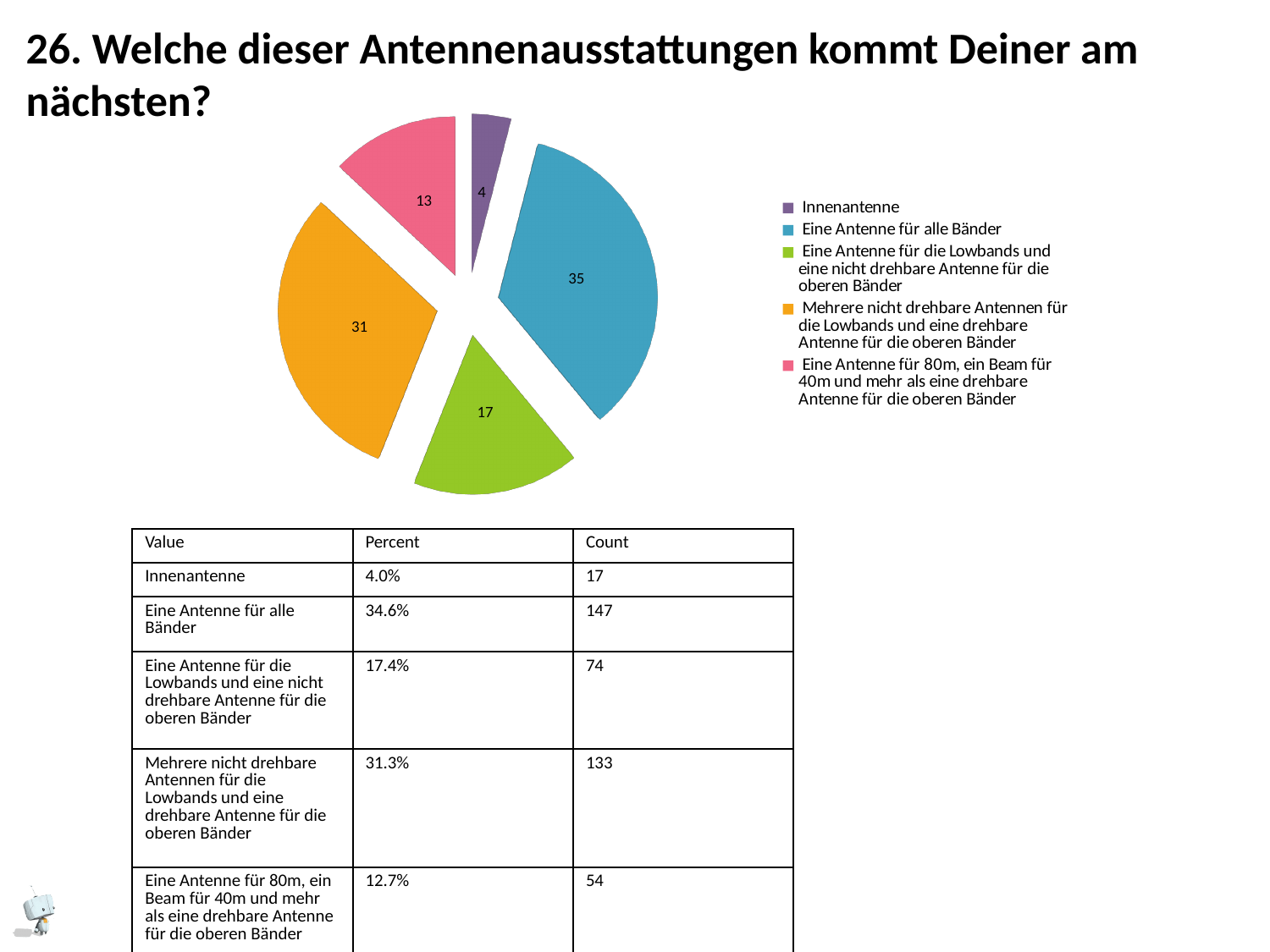
How many slices does the pie chart have? 5 Which category has the largest slice in the pie chart? Eine Antenne für alle Bänder What value is labelled on the pie slice for "Innenantenne"? 4 What is the difference between the labelled values of the "Eine Antenne für alle Bänder" slice and the "Innenantenne" slice? 31 Which category has the smallest slice in the pie chart? Innenantenne Which slice is larger: "Eine Antenne für 80m, ein Beam für 40m und mehr als eine drehbare Antenne für die oberen Bänder" or "Eine Antenne für die Lowbands und eine nicht drehbare Antenne für die oberen Bänder"? Eine Antenne für die Lowbands und eine nicht drehbare Antenne für die oberen Bänder What value is labelled on the pie slice for "Eine Antenne für die Lowbands und eine nicht drehbare Antenne für die oberen Bänder"? 17 What value is labelled on the pie slice for "Mehrere nicht drehbare Antennen für die Lowbands und eine drehbare Antenne für die oberen Bänder"? 31 What value is labelled on the pie slice for "Eine Antenne für alle Bänder"? 35 What colour is the slice for "Innenantenne" in the pie chart? purple What kind of chart is shown on the slide? pie chart How many entries does the legend of the pie chart list? 5